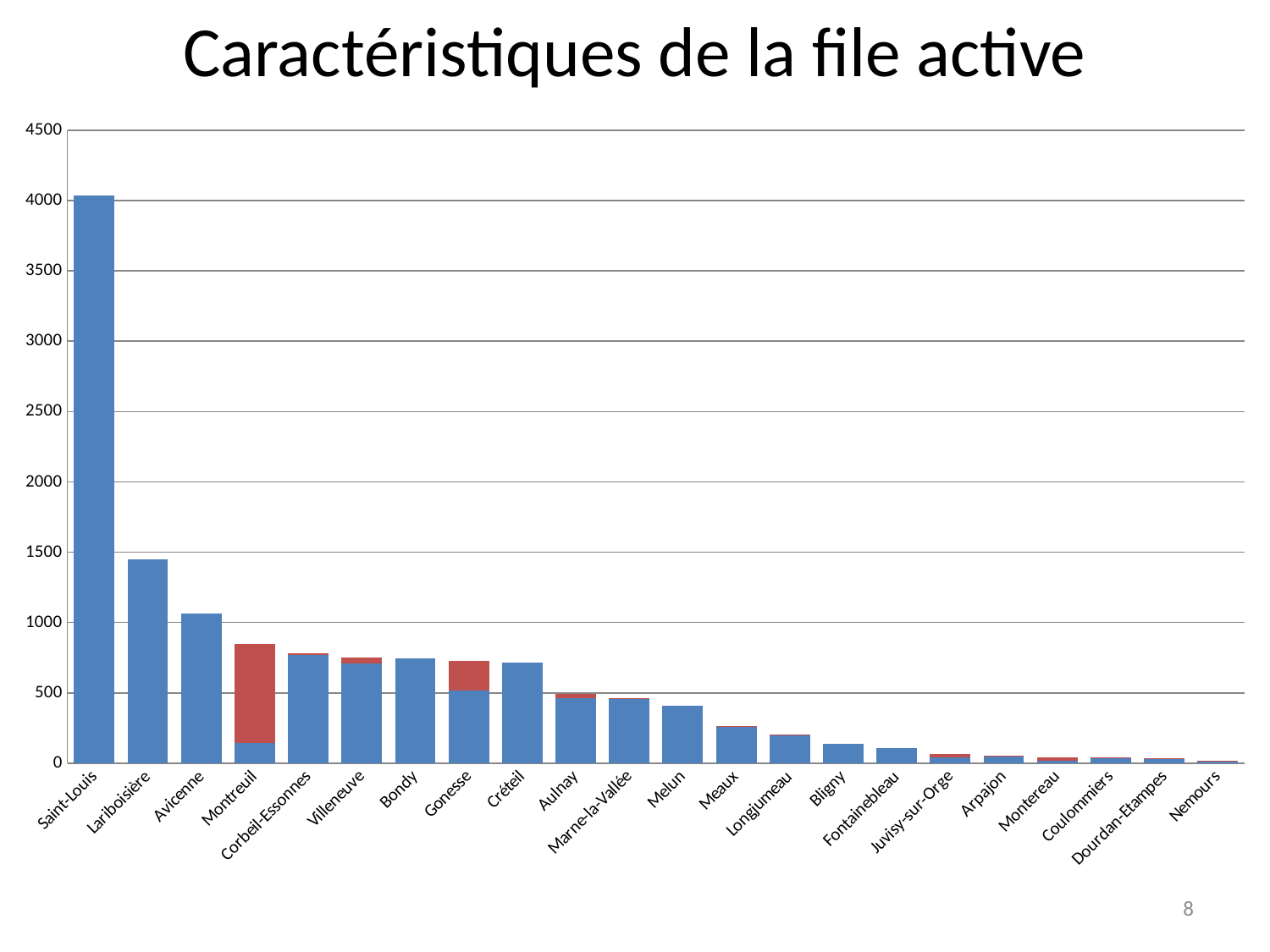
What is the title of the chart? Caractéristiques de la file active Which category has the lowest total bar in the chart? Nemours Is the total value for Avicenne greater or less than 1000? greater Which category has the highest total bar in the chart? Saint-Louis Which has a larger total bar, Saint-Louis or Lariboisière? Saint-Louis What two colours are used for the bar segments in the chart? blue and red Is the total value for Lariboisière greater or less than 1500? less Do the total bar values generally rise or fall from left to right along the x axis? fall What type of chart is shown on the slide? bar chart How many categories (sites) are shown on the x axis of the chart? 22 Is the total value for Melun greater or less than 500? less